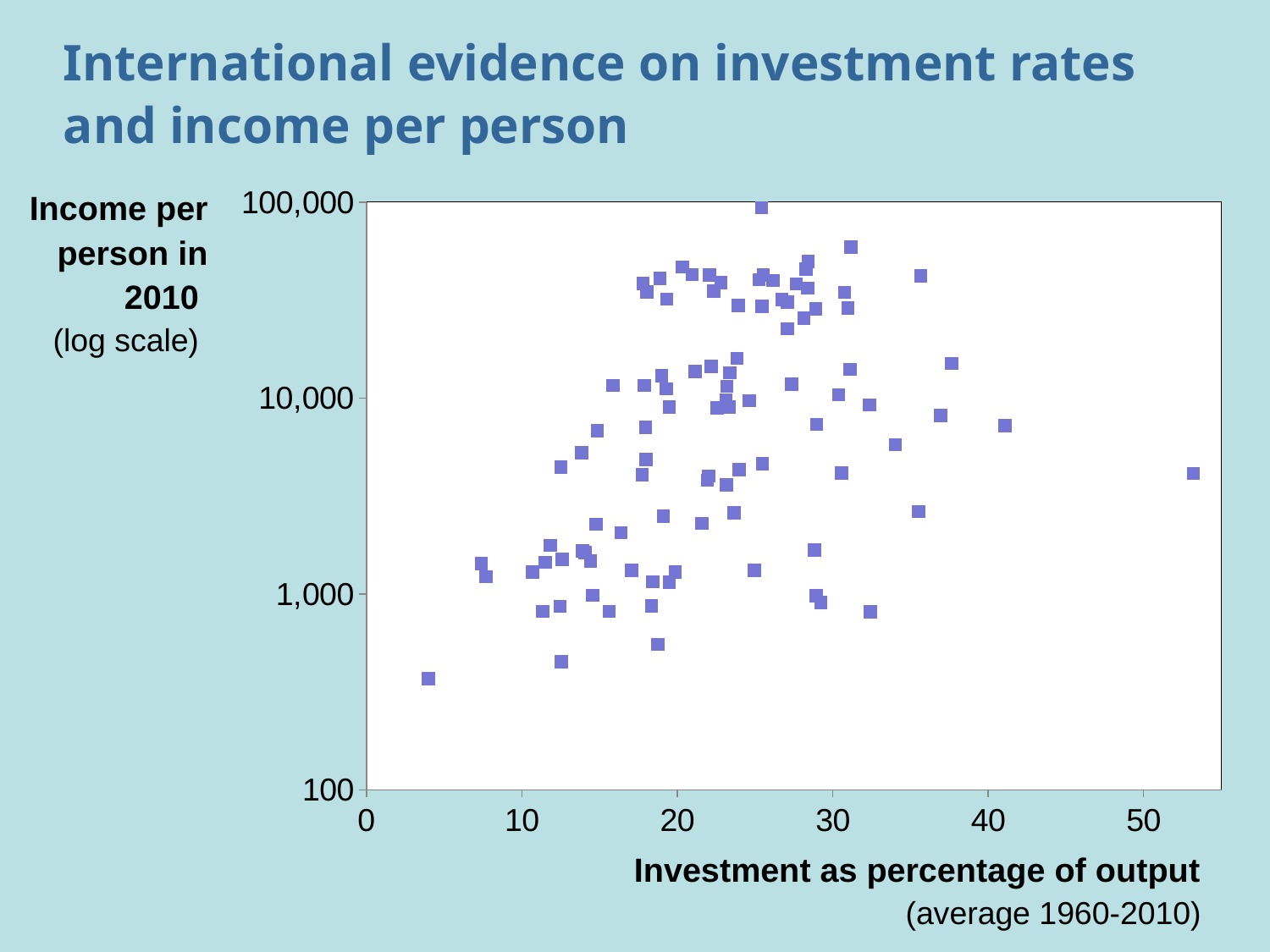
Is the investment rate of the point with the highest income per person (the topmost point) greater or less than 20? greater Is the investment rate of the topmost point greater or less than 30? less Is the income per person of the leftmost point greater or less than 1,000? less In general, does income per person rise or fall as investment as a percentage of output increases? Rise What kind of chart is shown on the slide? Scatter plot What variable is plotted on the horizontal axis of the chart? Investment as percentage of output (average 1960-2010) What is the title of the chart on the slide? International evidence on investment rates and income per person What is the highest value labelled on the vertical axis of the chart? 100,000